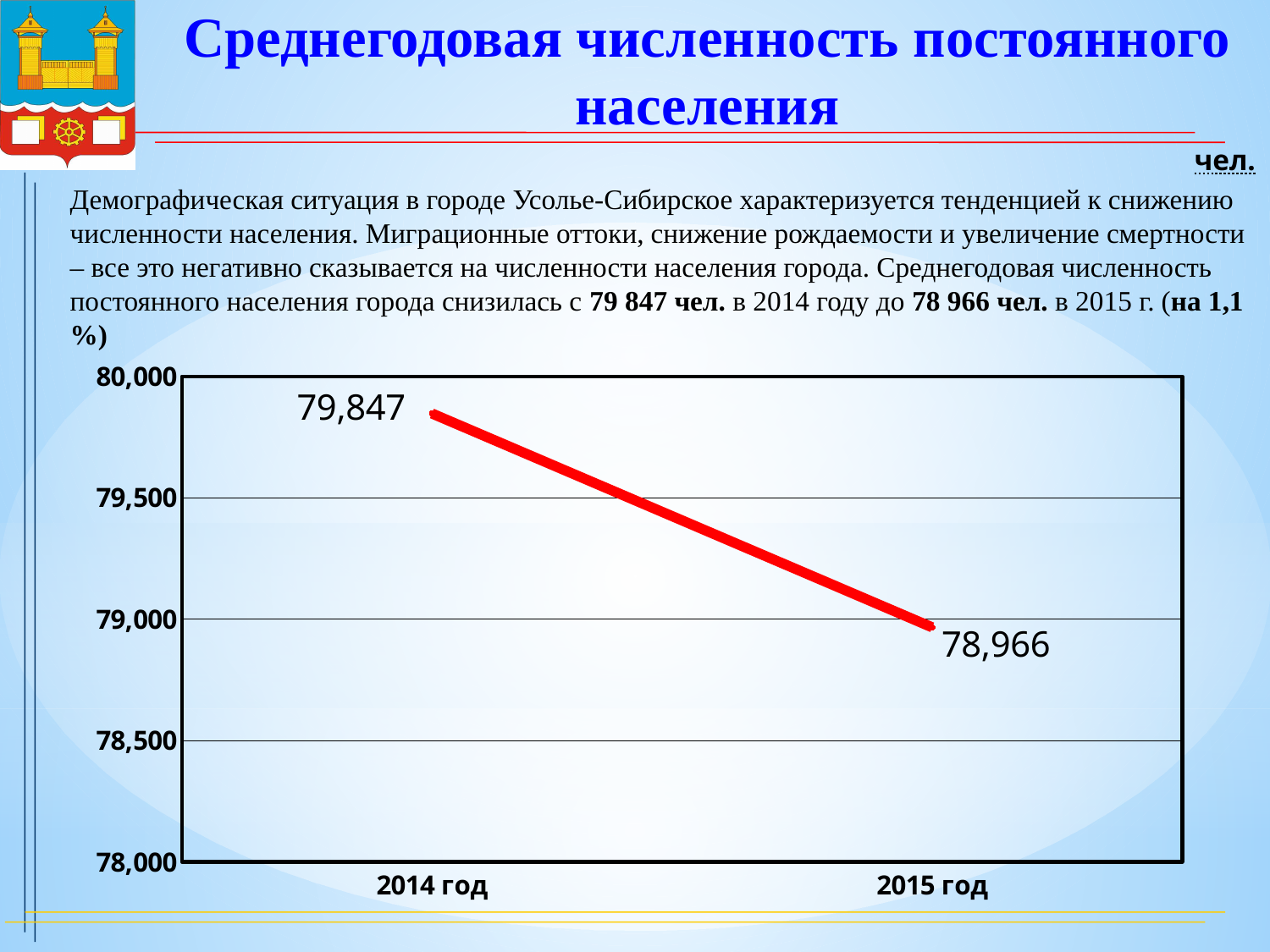
Which year has the higher population value on the chart? 2014 год What is the average annual permanent population shown for 2015 год? 78,966 What is the average annual permanent population shown for 2014 год? 79,847 Is the value for 2014 год greater or less than 79,500? greater How many data points are plotted on the chart? 2 Is the value for 2015 год greater or less than 79,000? less Which year has the lower population value on the chart? 2015 год Do the values rise or fall from 2014 год to 2015 год? fall By how much did the population value decrease from 2014 год to 2015 год? 881 What kind of chart is shown on the slide? line chart Is the value for 2014 год larger or smaller than the value for 2015 год? larger What colour is the line on the chart? red